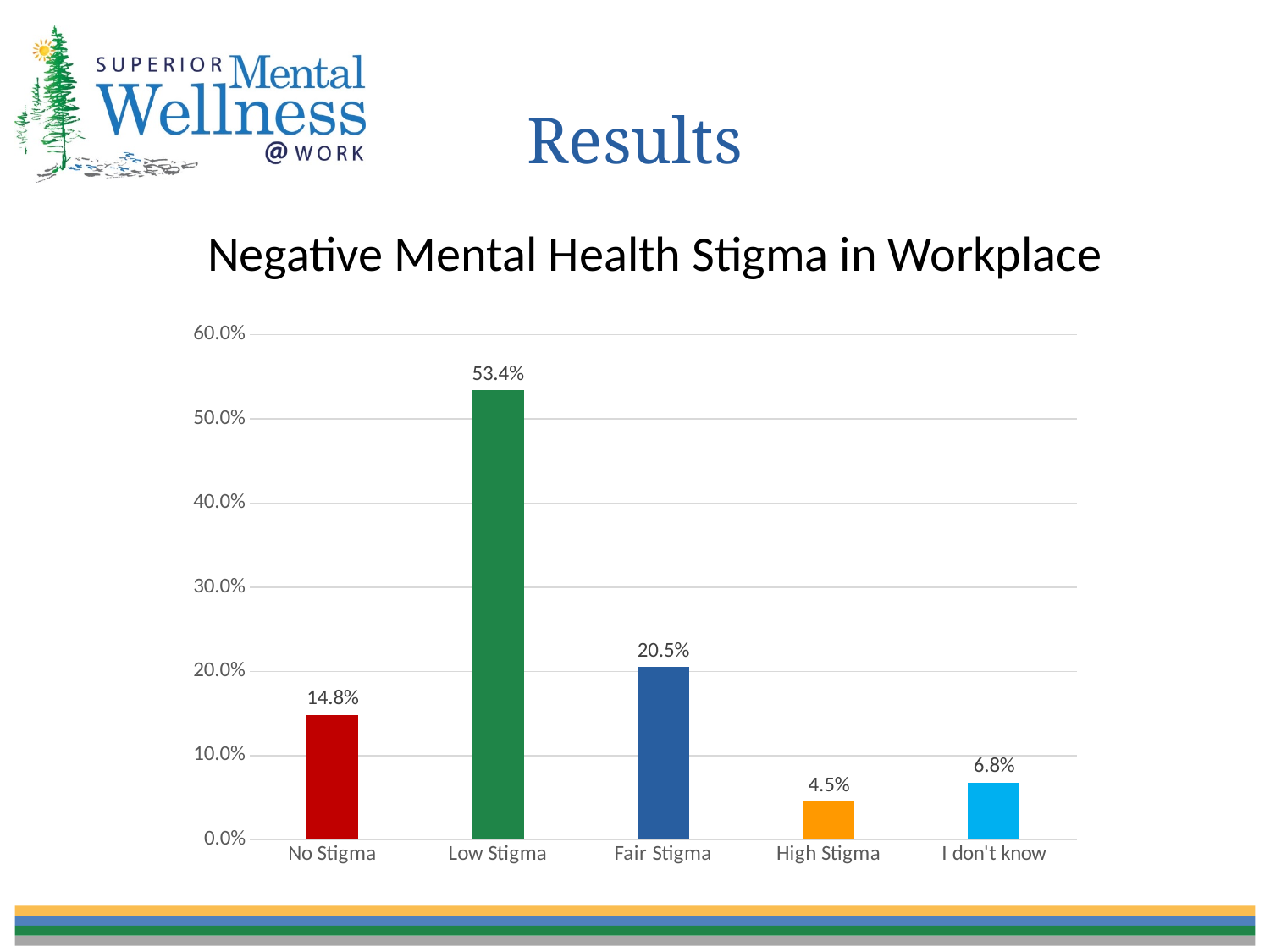
What is the value for No Stigma? 14.8% What is the value for I don't know? 6.8% What is the value for Low Stigma? 53.4% Is the value for Fair Stigma greater or less than 30.0%? less How many categories are shown on the x axis? 5 What kind of chart is shown on the slide? bar chart What is the title of the chart? Negative Mental Health Stigma in Workplace Which category has the lowest value? High Stigma What is the difference between the values for Low Stigma and Fair Stigma? 32.9% What is the value for High Stigma? 4.5% Which is larger, the value for No Stigma or the value for Fair Stigma? Fair Stigma Which category has the highest value? Low Stigma